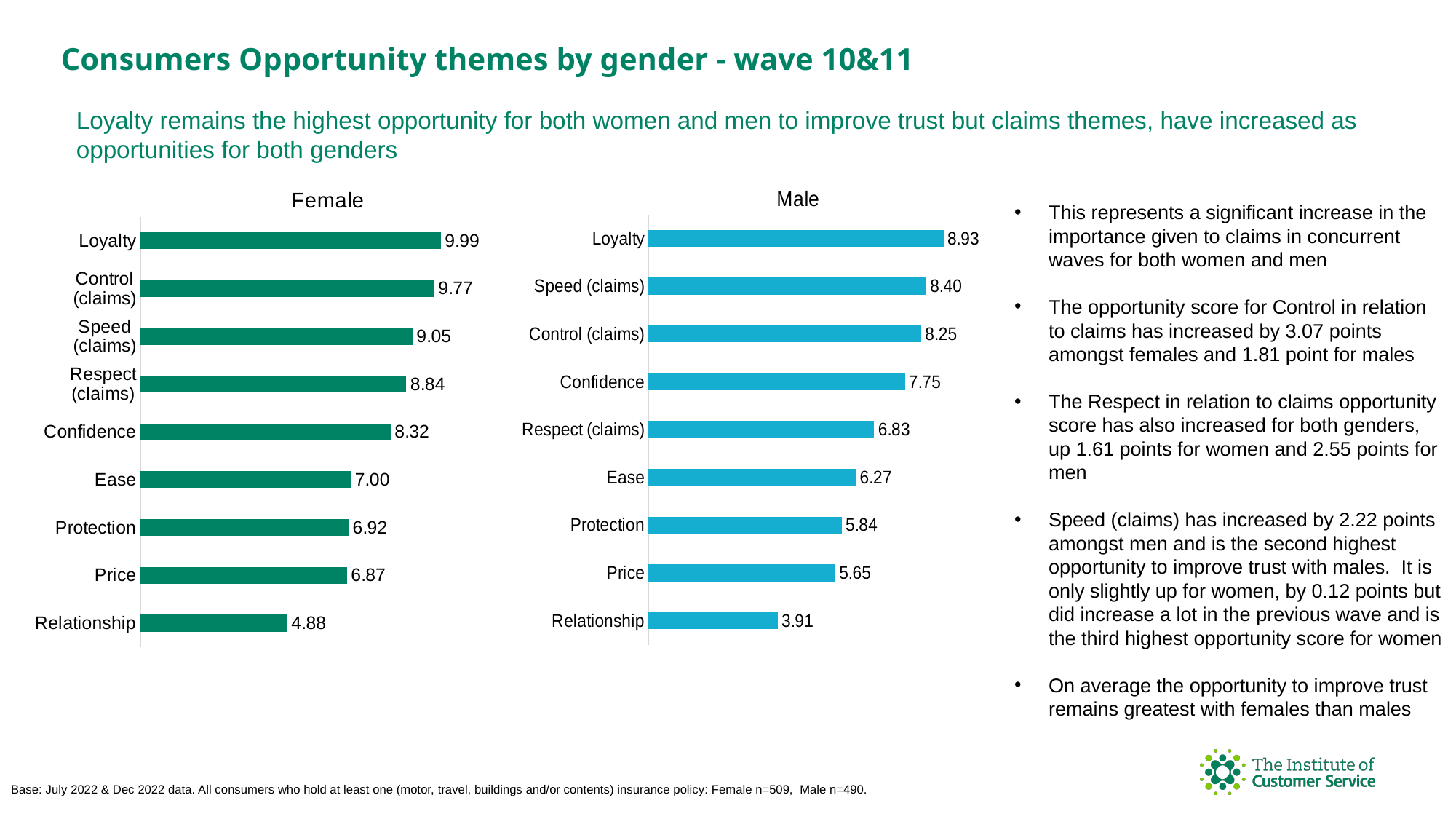
In the Male chart, which category has the lowest value? Relationship What is the title of the chart on the left? Female In the Male chart, what is the difference between the values for Confidence and Respect (claims)? 0.92 What type of chart is the Male chart? Bar chart How many categories are shown in the Female chart? 9 In the Female chart, what is the value for Control (claims)? 9.77 Which is larger: the value for Ease in the Female chart or the value for Ease in the Male chart? Female In the Male chart, what is the value for Relationship? 3.91 In the Female chart, what is the difference between the values for Loyalty and Relationship? 5.11 In the Female chart, which category has the highest value? Loyalty In the Male chart, which is larger: Protection or Price? Protection In the Male chart, what is the value for Speed (claims)? 8.40